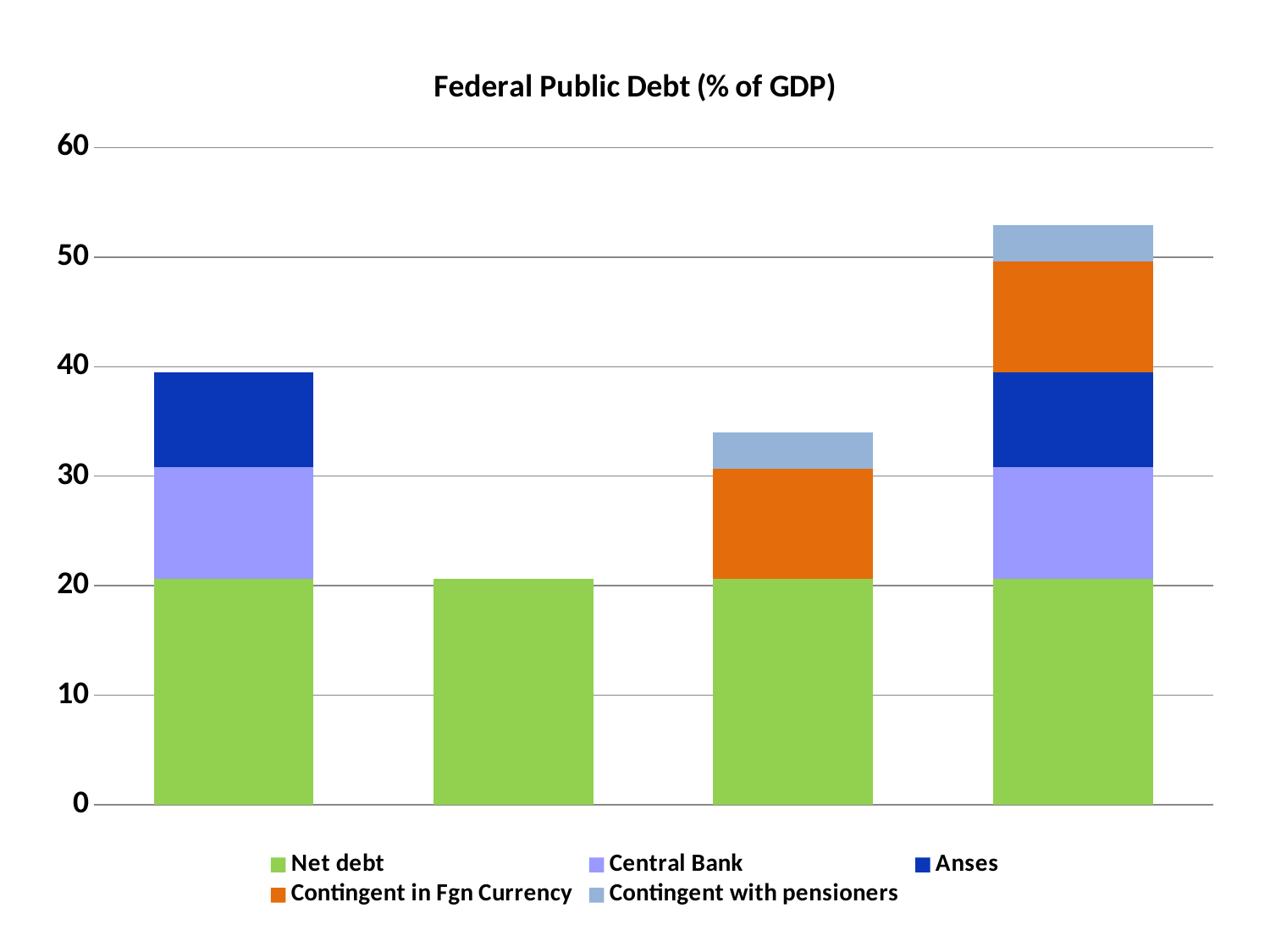
Which series is shown in green in the legend? Net debt How many series does the legend list? 5 Is the total of the third bar from the left greater or less than 30? greater Which bar has the highest total, counting from the left? The fourth bar How many bars are plotted in the chart? 4 What kind of chart is shown on the slide? Stacked bar chart Is the total of the fourth (rightmost) bar greater or less than 50? greater Which bar has the lowest total, counting from the left? The second bar What is the title of the chart? Federal Public Debt (% of GDP) Is the total of the first (leftmost) bar greater or less than 30? greater Which is larger, the total of the first bar or the total of the third bar? The first bar